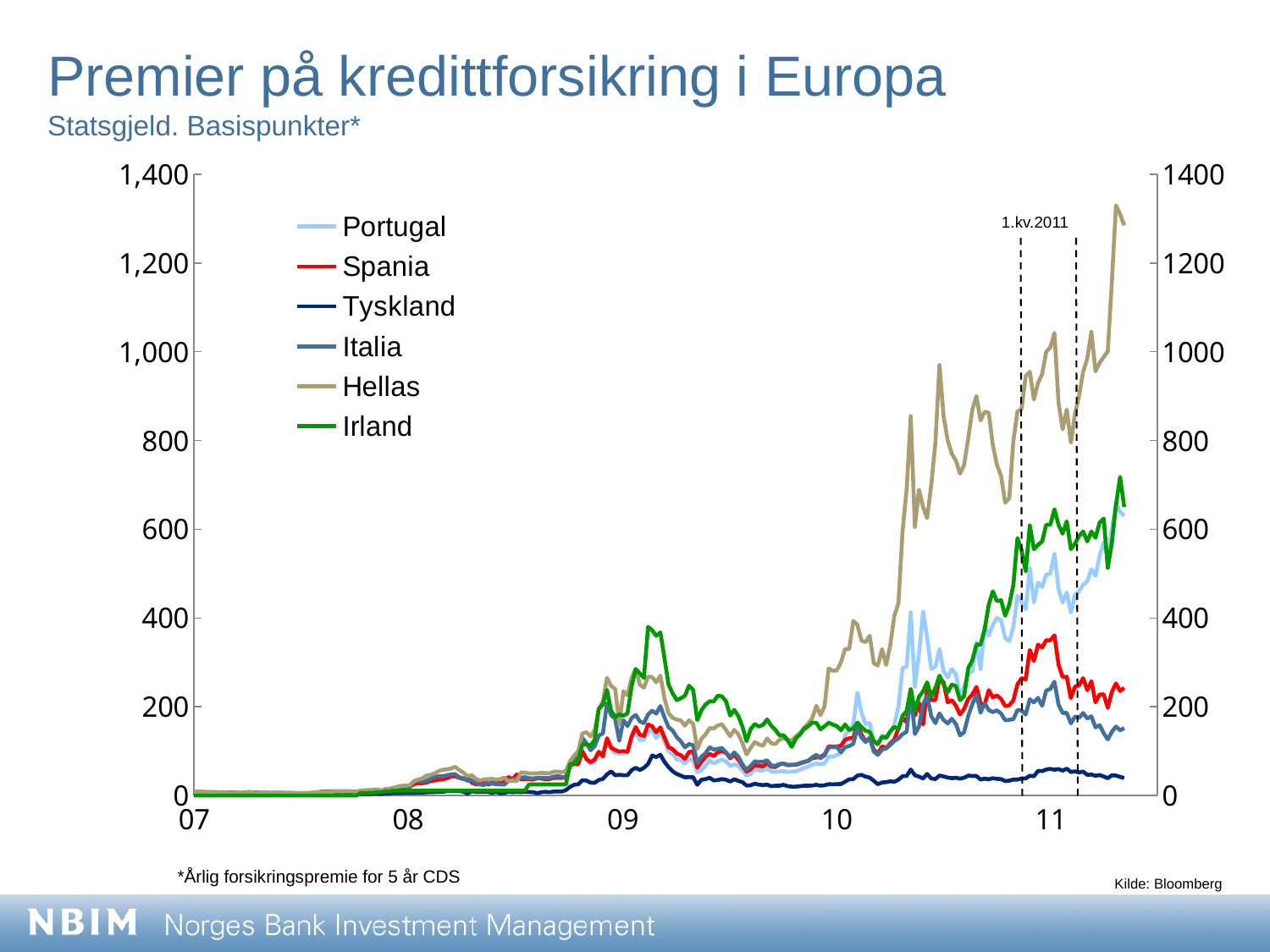
What is the title of the chart on the slide? Premier på kredittforsikring i Europa Is the value for Irland at the end of the chart greater or less than 400? greater Which series reaches the highest value on the chart? Hellas What kind of chart is shown on the slide? line chart How many series does the legend list? 6 Which series stays lowest across the chart? Tyskland Is the peak value for Hellas greater or less than 1200? greater At the end of the chart, which is higher: Spania or Italia? Spania What label is written above the two dashed vertical lines on the chart? 1.kv.2011 At the end of the chart, which is higher: Hellas or Portugal? Hellas Do the values for Hellas generally rise or fall from 2010 to 2011? rise Is the value for Tyskland at the end of the chart greater or less than 200? less